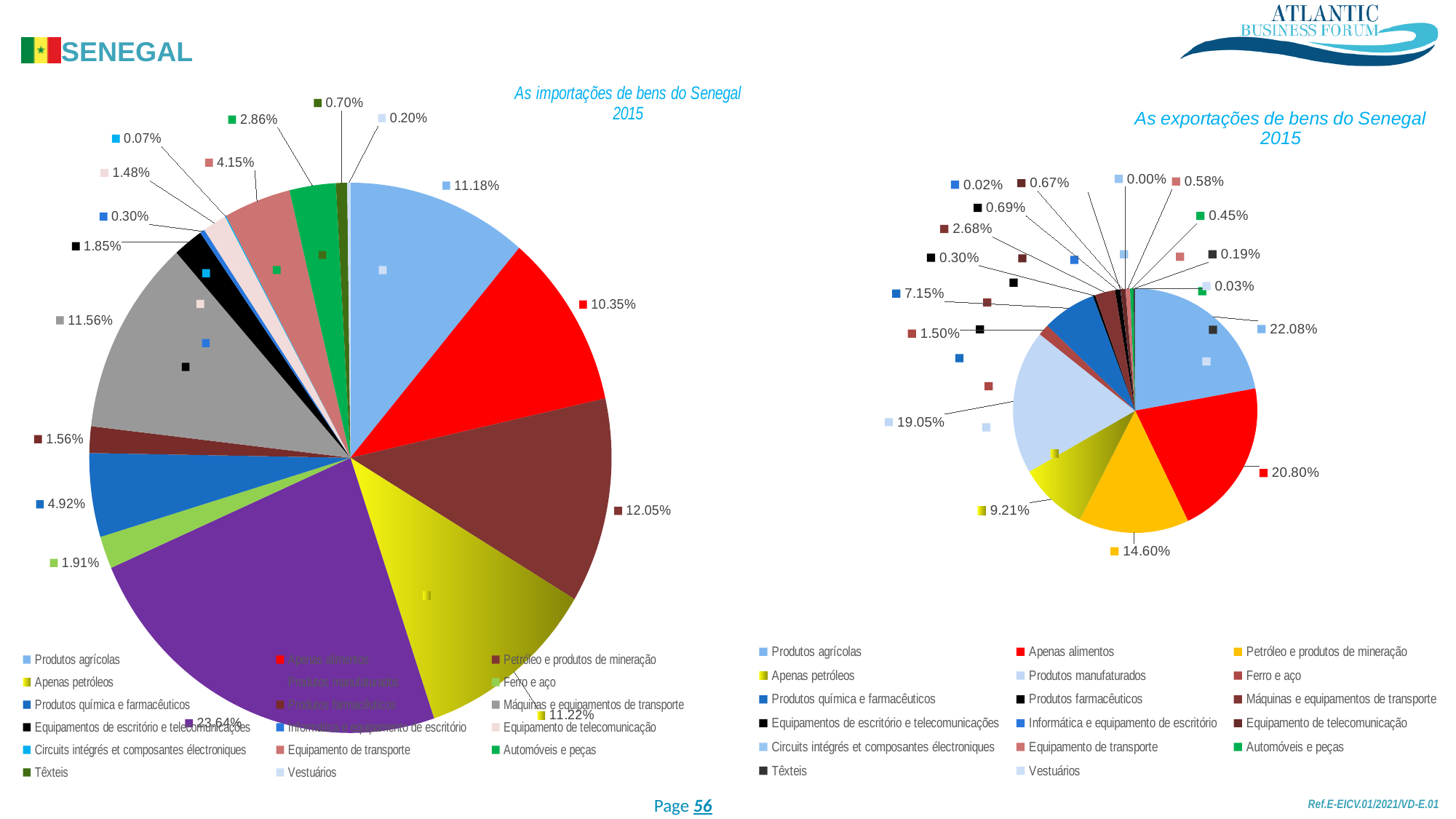
In the chart 'As exportações de bens do Senegal 2015', what is the share for Apenas alimentos? 20.80% In the chart 'As exportações de bens do Senegal 2015', what is the share for Produtos manufaturados? 19.05% How many entries does the legend of the chart 'As exportações de bens do Senegal 2015' list? 17 In the chart 'As exportações de bens do Senegal 2015', what is the share for Produtos agrícolas? 22.08% In the chart 'As importações de bens do Senegal 2015', what is the share for Produtos manufaturados? 23.64% In the chart 'As exportações de bens do Senegal 2015', what is the difference between the shares of Produtos agrícolas and Apenas alimentos? 1.28% What type of chart is 'As exportações de bens do Senegal 2015'? Pie chart In the chart 'As exportações de bens do Senegal 2015', what is the share for Petróleo e produtos de mineração? 14.60% In the chart 'As exportações de bens do Senegal 2015', which category has the largest slice? Produtos agrícolas In the chart 'As importações de bens do Senegal 2015', which is larger: the share for Produtos agrícolas or the share for Apenas alimentos? Produtos agrícolas In the chart 'As importações de bens do Senegal 2015', which category has the largest slice? Produtos manufaturados In the chart 'As importações de bens do Senegal 2015', what is the share for Petróleo e produtos de mineração? 12.05%